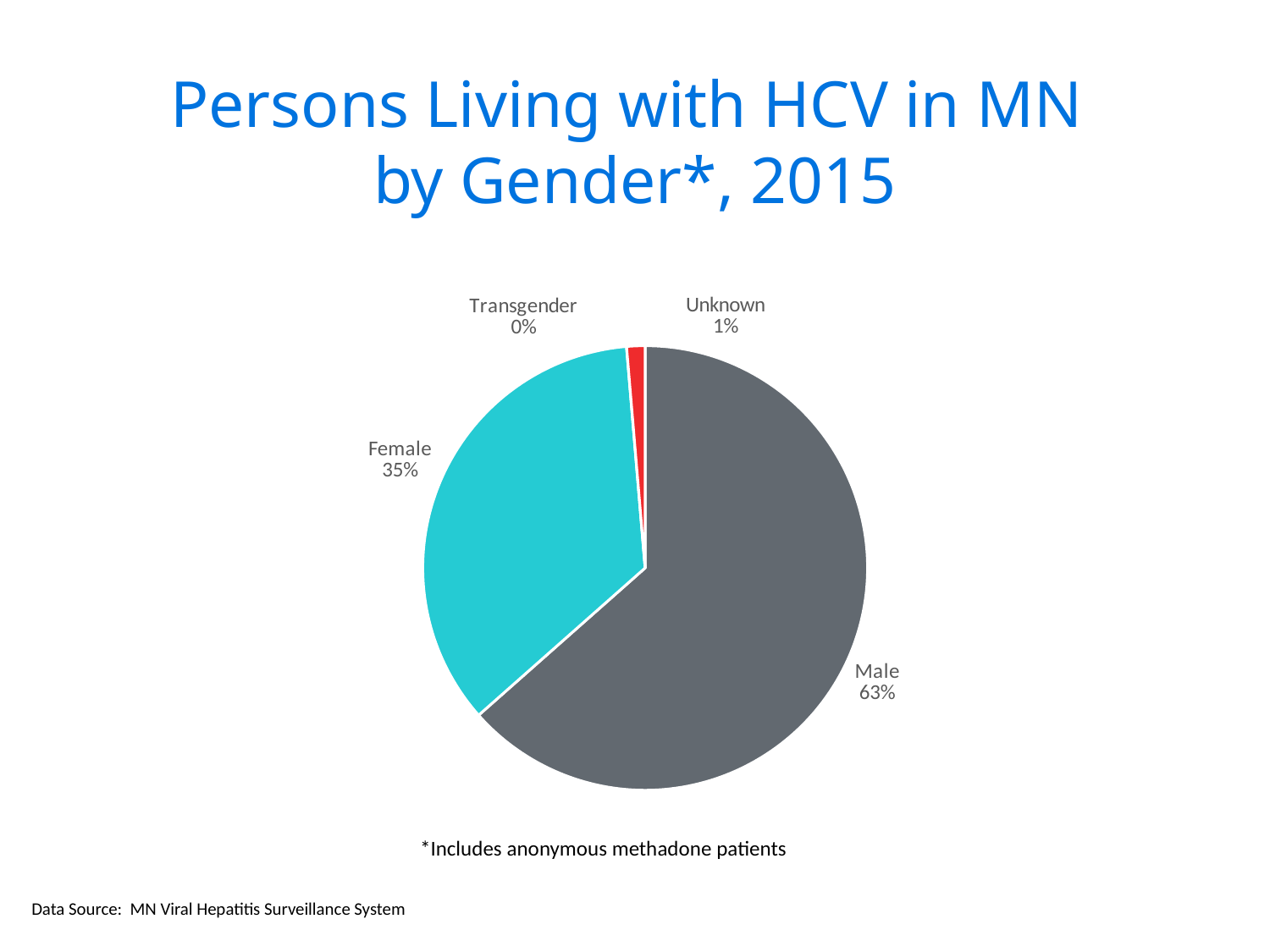
What percentage is shown for the Unknown gender category? 1% What percentage of persons living with HCV in MN in 2015 are Female? 35% How many gender categories are shown in the pie chart? 4 Which gender category has the smallest share of the pie? Transgender What is the difference in percentage points between the Male and Female shares? 28 What kind of chart is shown on the slide? Pie chart What is the title of the chart? Persons Living with HCV in MN by Gender*, 2015 What data source is cited on the slide? MN Viral Hepatitis Surveillance System Which gender category has the largest share of the pie? Male What percentage is shown for the Transgender category? 0% What percentage of persons living with HCV in MN in 2015 are Male? 63% Which is larger, the Female share or the Unknown share? Female